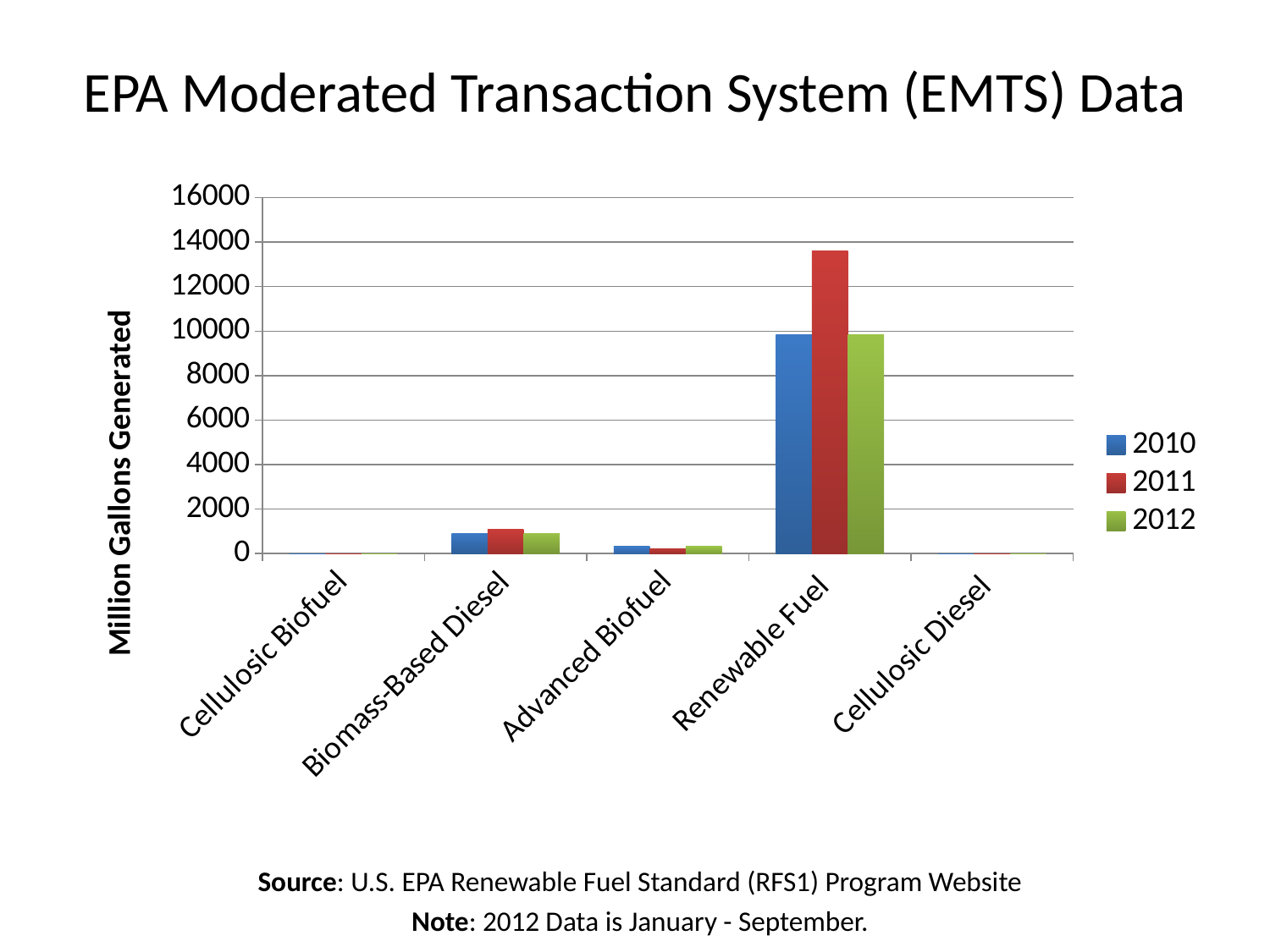
What kind of chart is shown on the slide? bar chart What is the label on the vertical axis? Million Gallons Generated Is the 2011 value for Biomass-Based Diesel greater or less than 2000? less Which fuel category has the highest values in the chart? Renewable Fuel Is the 2011 value for Renewable Fuel greater or less than 12000? greater How many fuel categories are shown on the x axis? 5 Which is larger: the 2011 value for Biomass-Based Diesel or the 2011 value for Advanced Biofuel? Biomass-Based Diesel For Renewable Fuel, which is larger: the 2011 value or the 2010 value? 2011 Which year has the highest bar for Renewable Fuel? 2011 Which years are listed in the legend? 2010, 2011, 2012 How many series does the legend list? 3